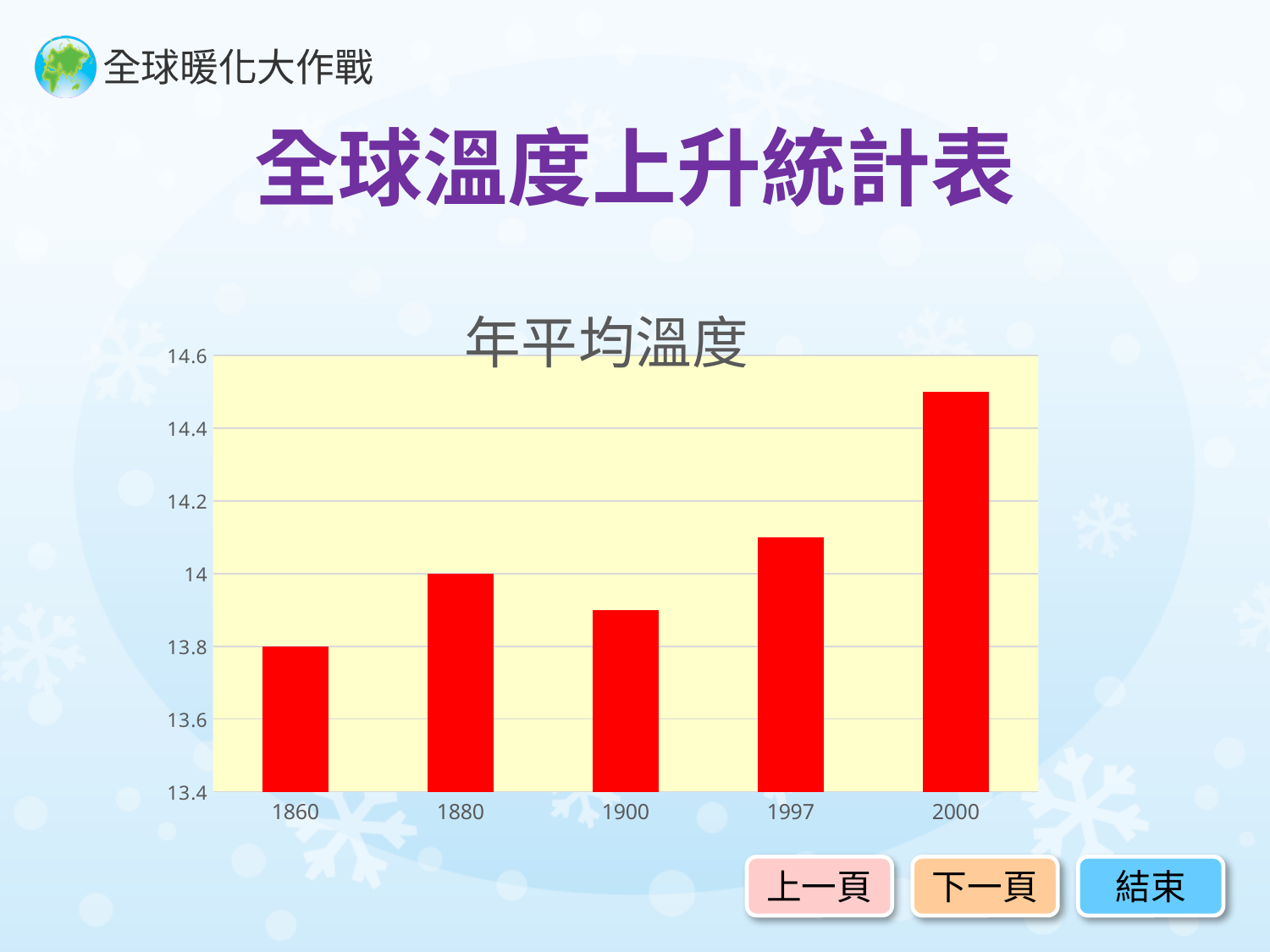
Which is larger, the value for 1880 or the value for 1900? 1880 Is the value for 2000 greater or less than 14.4? greater Which year has the lowest value in the chart? 1860 What is the value for 1860 in the chart? 13.8 What type of chart is shown on the slide? bar chart What is the value for 1880 in the chart? 14 Which year has the highest value in the chart? 2000 What is the title of the chart? 年平均溫度 What colour are the bars in the chart? red Is the value for 1900 greater or less than 14? less How many years (categories) are shown on the x axis of the chart? 5 What is the difference between the values for 1880 and 1860? 0.2